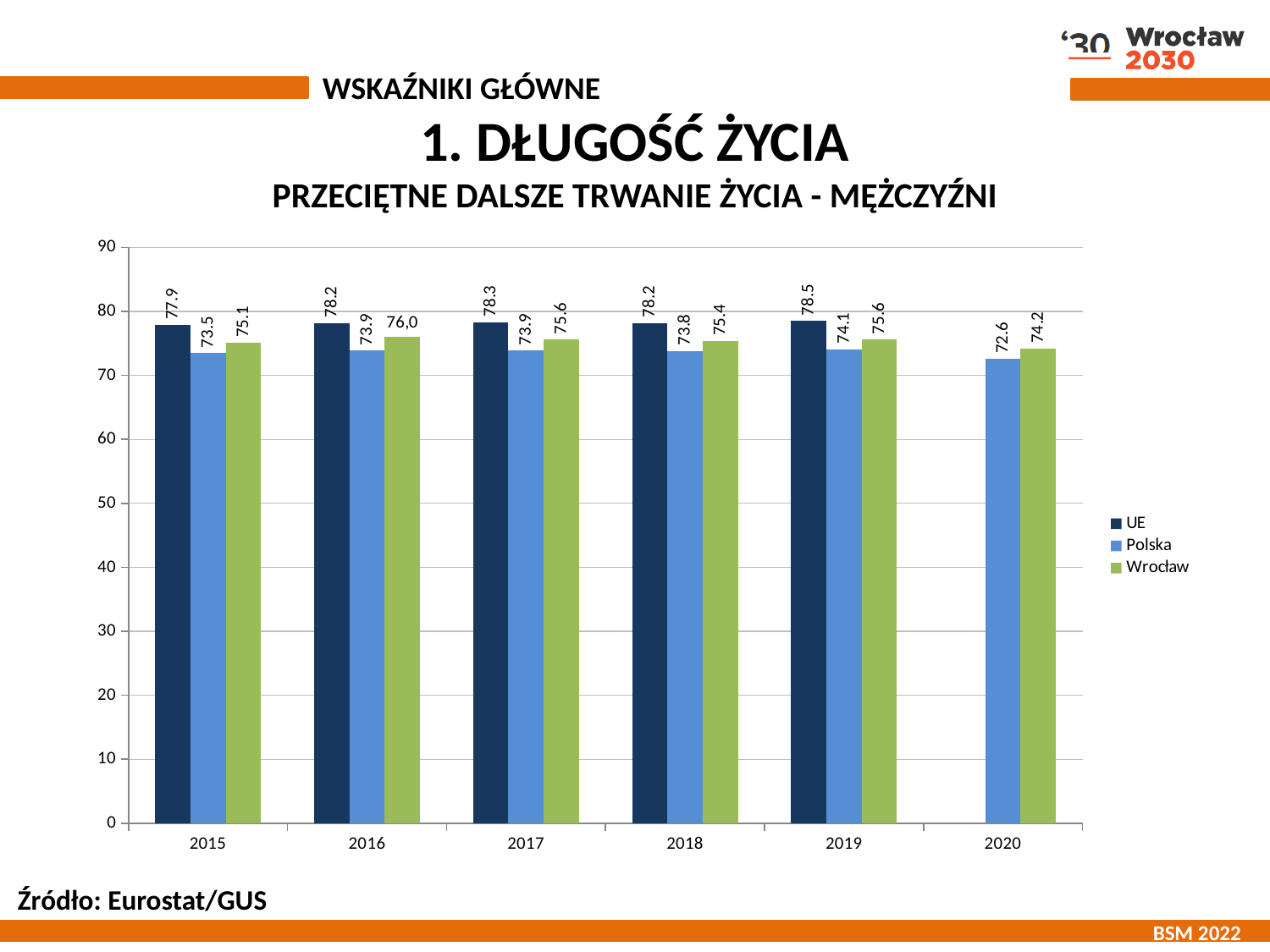
In which year is the UE value highest? 2019 In which year is the Polska value lowest? 2020 What is the value for Wrocław in 2016? 76,0 Is the value for Wrocław in 2020 greater or less than 70? greater Which series has no bar for 2020? UE How many series does the legend list? 3 Which is larger in 2018: the value for Wrocław or the value for Polska? Wrocław What is the value for Polska in 2020? 72.6 What kind of chart is shown on the slide? bar chart How many years are shown on the x axis? 6 What is the value for UE in 2019? 78.5 What is the difference between the UE and Polska values in 2015? 4.4